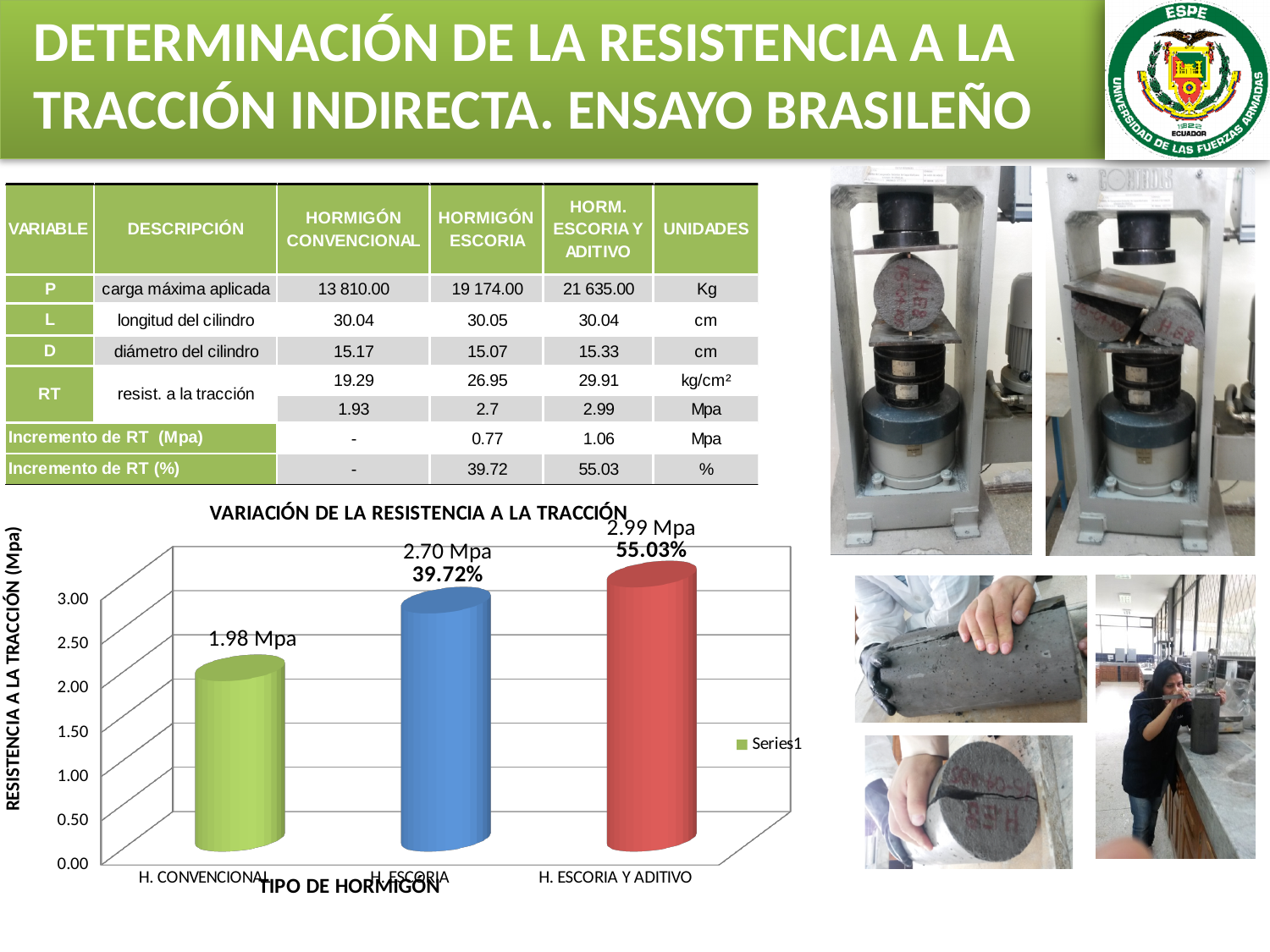
Which type of concrete has the highest tensile strength in the chart? H. ESCORIA Y ADITIVO What is the value labelled for H. ESCORIA in the chart? 2.70 Mpa What percentage increase is labelled above the H. ESCORIA Y ADITIVO bar? 55.03% What type of chart is shown under the title 'VARIACIÓN DE LA RESISTENCIA A LA TRACCIÓN'? Bar chart Which has a larger value in the chart, H. CONVENCIONAL or H. ESCORIA? H. ESCORIA How many types of concrete are plotted in the chart? 3 What is the value labelled for H. CONVENCIONAL in the chart? 1.98 Mpa What is the value labelled for H. ESCORIA Y ADITIVO in the chart? 2.99 Mpa Do the values rise or fall from left to right across the chart? Rise Which type of concrete has the lowest tensile strength in the chart? H. CONVENCIONAL What is the difference in Mpa between H. ESCORIA Y ADITIVO and H. ESCORIA in the chart? 0.29 Mpa